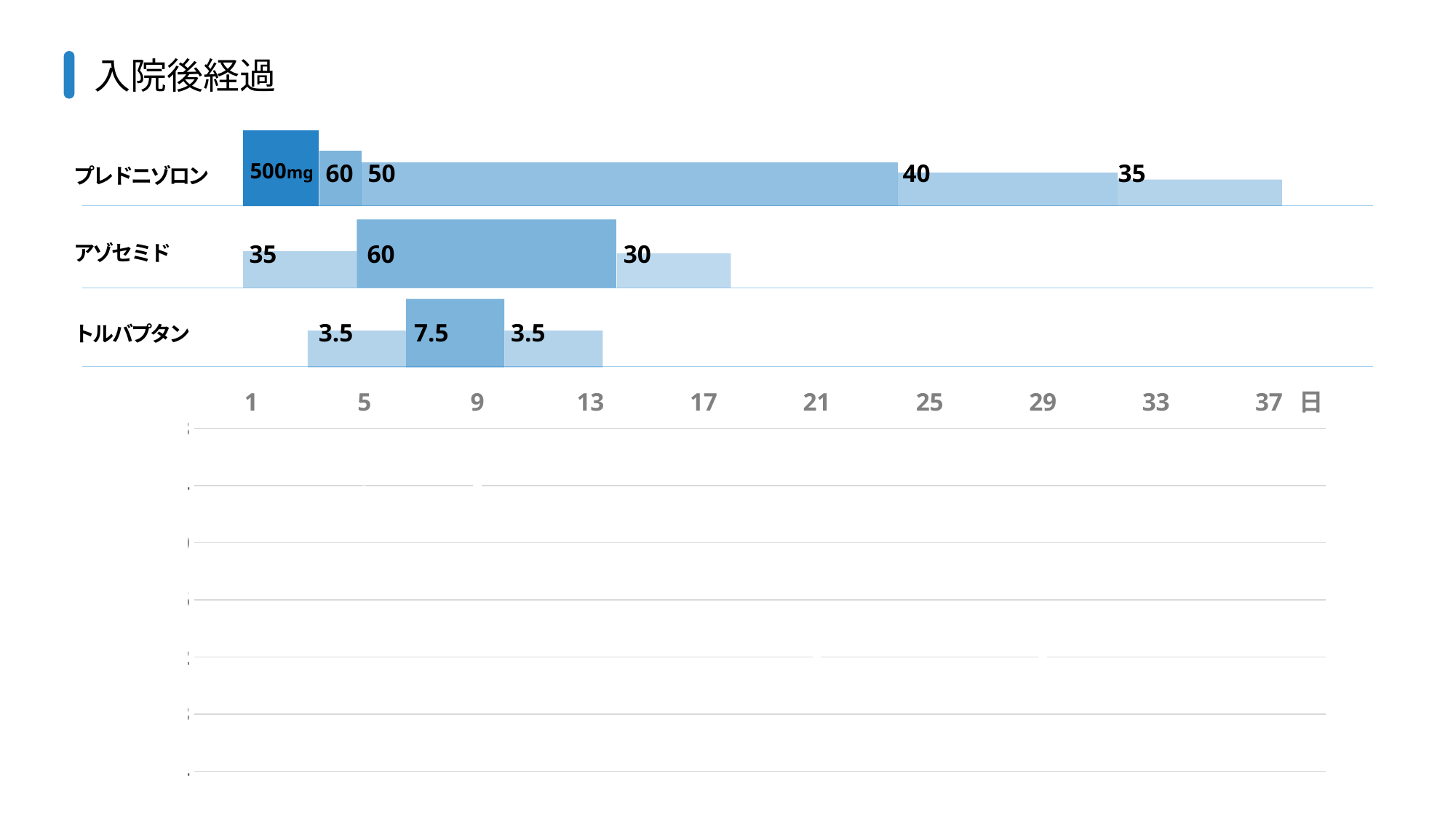
How many drugs are listed on the chart? 3 Do the doses of プレドニゾロン rise or fall over the days? fall What is the first dose shown for プレドニゾロン? 500mg What is the highest dose shown for トルバプタン? 7.5 What is the lowest dose shown for トルバプタン? 3.5 How many dose segments are shown for プレドニゾロン? 5 Which is larger, the highest dose of アゾセミド or the highest dose of トルバプタン? アゾセミド What is the difference between the highest and lowest doses shown for アゾセミド? 30 What is the title of the slide? 入院後経過 What is the highest dose shown for アゾセミド? 60 What is the last dose shown for プレドニゾロン? 35 What is the difference between the 7.5 and 3.5 doses of トルバプタン? 4